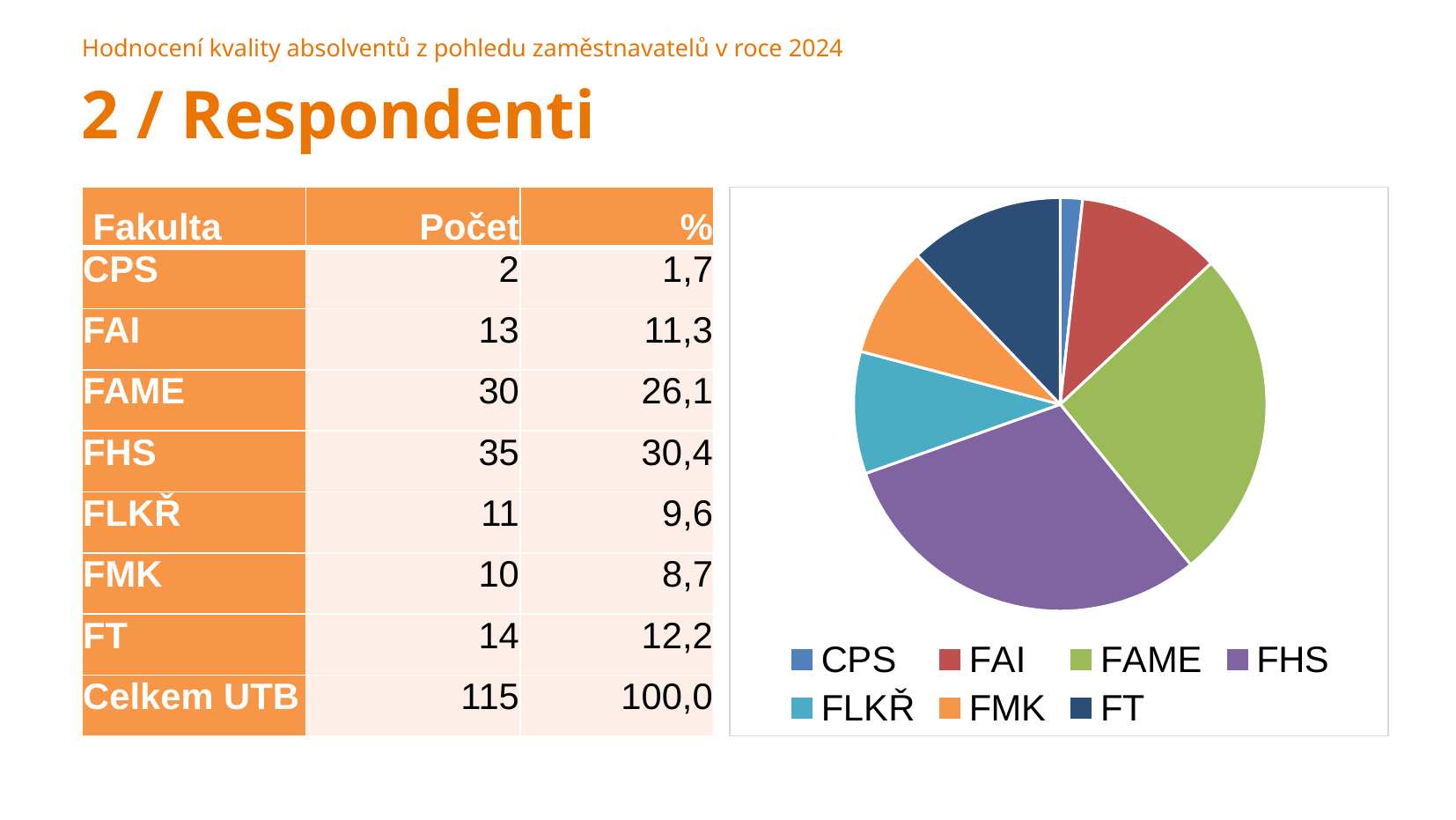
Which faculty has the smallest slice of the pie chart? CPS Which faculty has the largest slice of the pie chart? FHS How many entries does the pie chart's legend list? 7 According to the table on the slide, how many respondents (Počet) does the FT slice represent? 14 What kind of chart is shown on the slide? pie chart Is the slice for FT larger or smaller than the slice for FHS? smaller Is the slice for FAME larger or smaller than the slice for FAI? larger How many slices does the pie chart have? 7 Which colour is used for the FAME slice in the pie chart? green According to the table on the slide, what is the difference in respondent count between FHS and FAME? 5 According to the table on the slide, what share of respondents does the FHS slice represent? 30,4 According to the table on the slide, what share of respondents does the FAME slice represent? 26,1